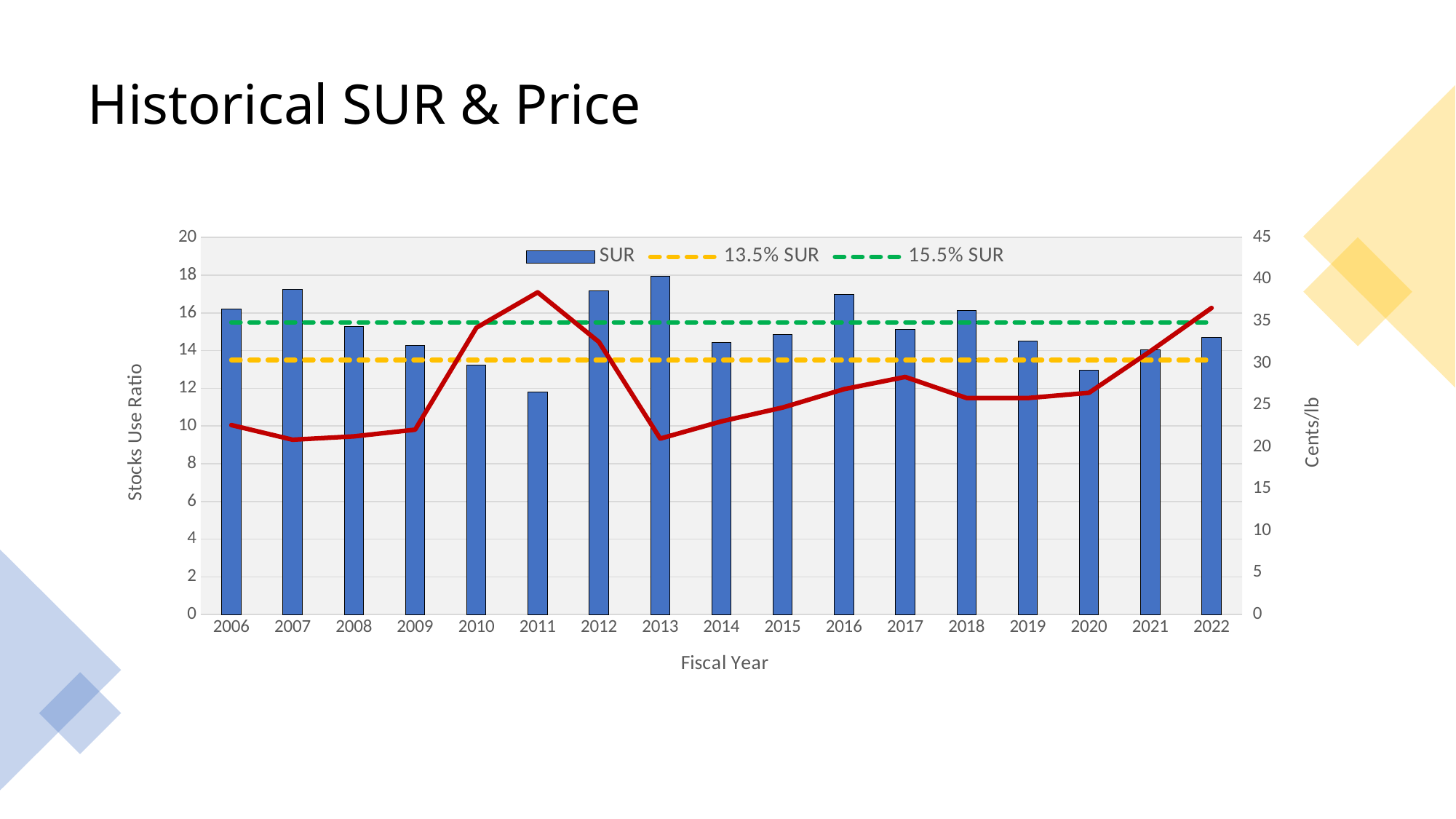
Is the SUR value for 2011 greater or less than 12? less Is the SUR value for 2020 greater or less than 14? less Is the SUR value for 2013 greater or less than 16? greater How many entries does the legend list? 3 Which fiscal year has the lowest SUR bar? 2011 What is the title of the chart? Historical SUR & Price Which fiscal year has the highest SUR bar? 2013 How many fiscal years are shown on the x axis? 17 What is the label of the right-hand vertical axis? Cents/lb What kind of chart is used to show the SUR series? Bar chart Which has the larger SUR bar, 2011 or 2012? 2012 Which has the larger SUR bar, 2006 or 2009? 2006